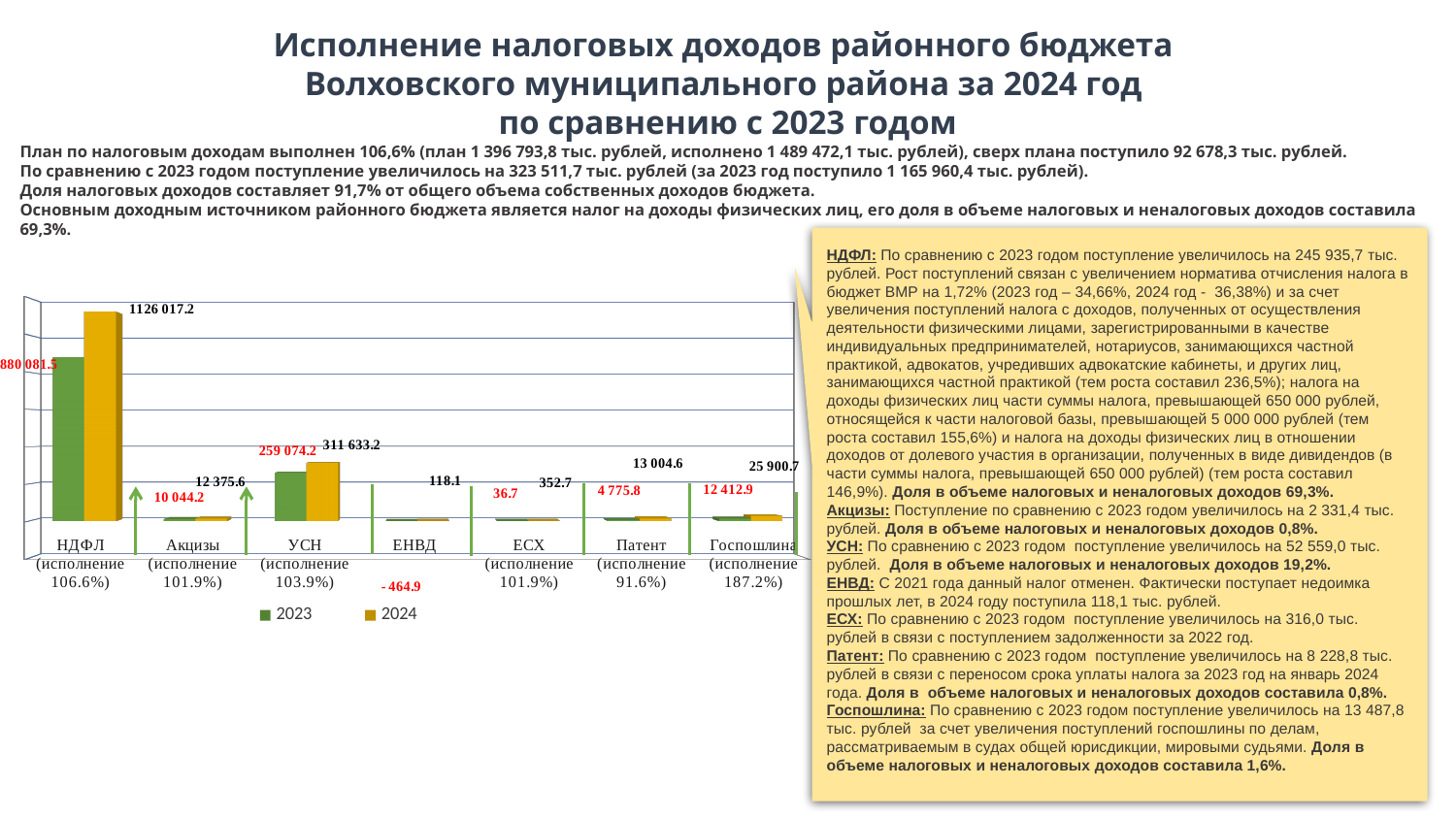
Which category has the lowest 2023 value? ЕНВД What is the 2024 value for НДФЛ? 1126 017.2 How many series does the chart legend list? 2 What is the difference between the 2024 and 2023 values for Патент? 8 228.8 What kind of chart is shown on the slide? bar chart For ЕСХ, which year has the larger value, 2023 or 2024? 2024 Which colour represents the 2023 series in the chart legend? green What is the 2023 value for ЕНВД? -464.9 What is the 2024 value for Госпошлина? 25 900.7 How many tax categories are shown on the x axis of the chart? 7 What is the 2023 value for УСН? 259 074.2 Which category has the highest 2024 value? НДФЛ